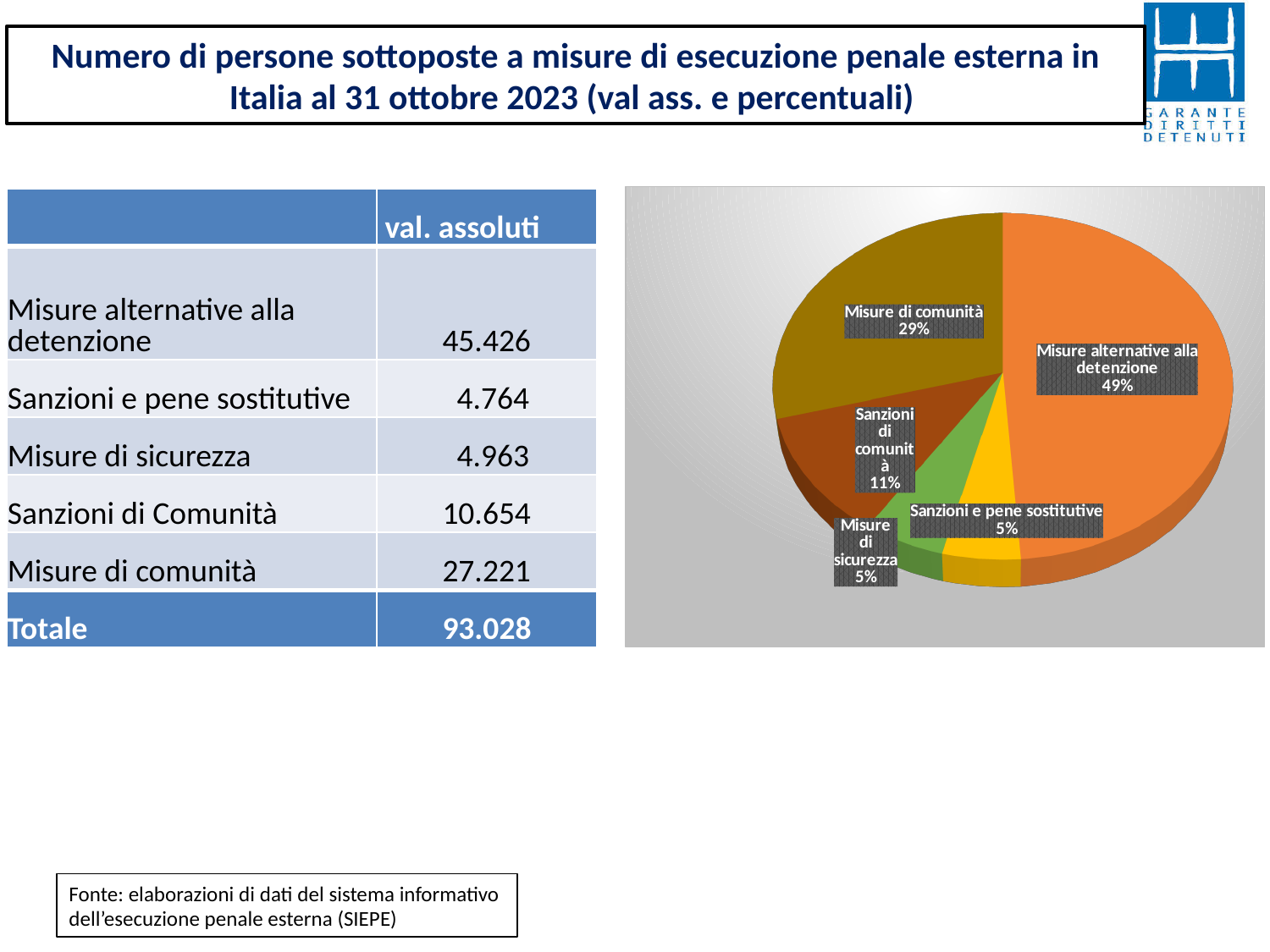
In the pie chart, what percentage is shown for Misure di sicurezza? 5% In the pie chart, what is the difference in percentage points between Misure di comunità and Sanzioni di comunità? 18 percentage points Which category has the largest slice in the pie chart? Misure alternative alla detenzione What colour is the slice for Misure alternative alla detenzione in the pie chart? Orange In the pie chart, what is the difference in percentage points between Misure alternative alla detenzione and Misure di comunità? 20 percentage points In the pie chart, what percentage is shown for Sanzioni di comunità? 11% In the pie chart, which is larger: Misure di comunità or Sanzioni di comunità? Misure di comunità What kind of chart is shown on the slide? Pie chart How many slices does the pie chart have? 5 In the pie chart, what percentage is shown for Sanzioni e pene sostitutive? 5% In the pie chart, what percentage is shown for Misure di comunità? 29% In the pie chart, what percentage is shown for Misure alternative alla detenzione? 49%